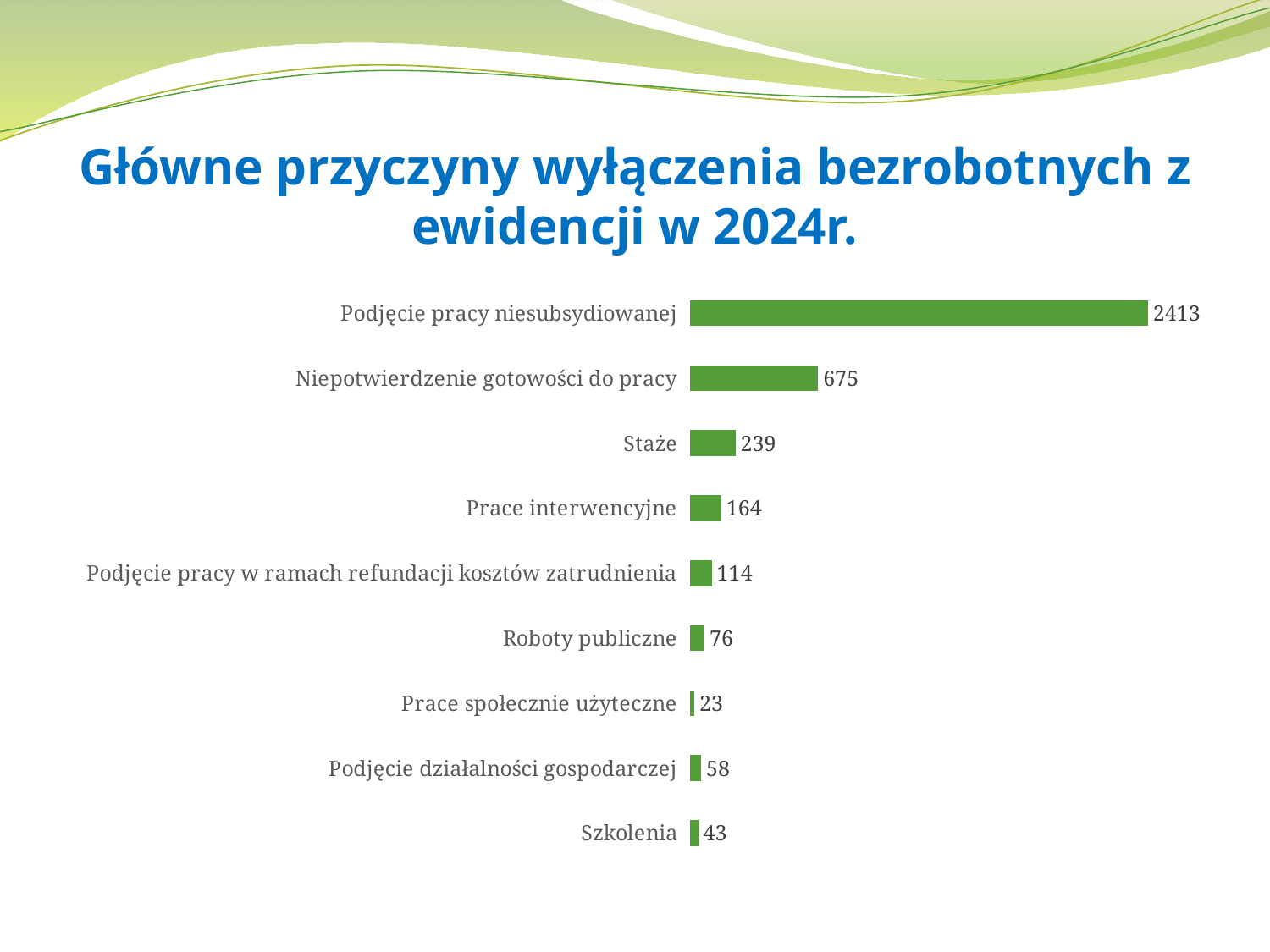
What is the value for Prace społecznie użyteczne? 23 What is the difference between the values for Prace interwencyjne and Podjęcie pracy w ramach refundacji kosztów zatrudnienia? 50 What is the title of the slide? Główne przyczyny wyłączenia bezrobotnych z ewidencji w 2024r. What is the value for Podjęcie pracy niesubsydiowanej? 2413 How many categories are shown in the chart? 9 What is the value for Niepotwierdzenie gotowości do pracy? 675 Which category has the lowest value? Prace społecznie użyteczne What is the value for Staże? 239 What is the difference between the values for Podjęcie pracy niesubsydiowanej and Niepotwierdzenie gotowości do pracy? 1738 What kind of chart is shown on the slide? Bar chart Which is larger, the value for Podjęcie działalności gospodarczej or the value for Szkolenia? Podjęcie działalności gospodarczej Which category has the highest value? Podjęcie pracy niesubsydiowanej